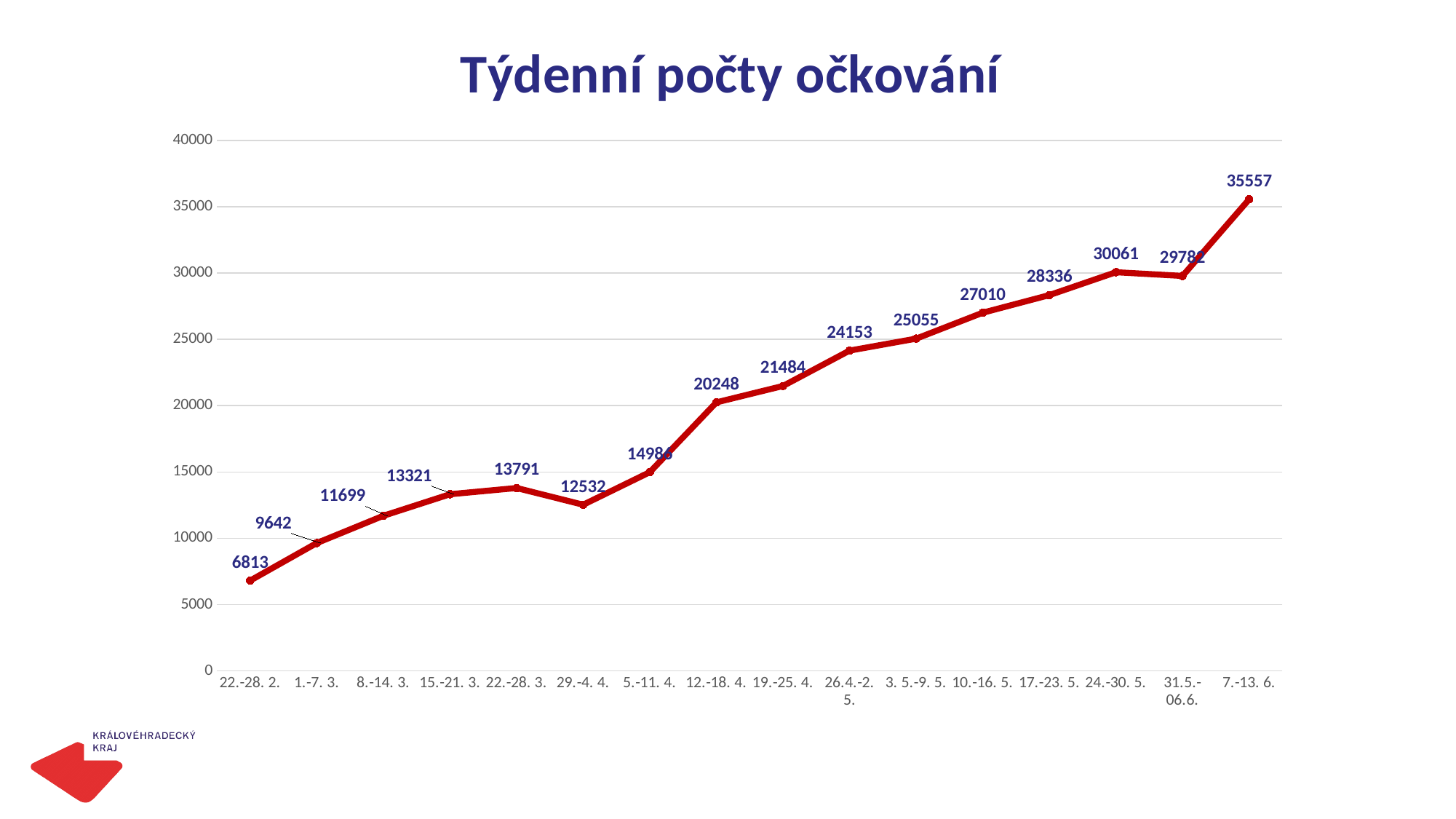
What type of chart is shown on the slide? line chart Which week has the lowest number of vaccinations? 22.-28. 2. What is the difference between the values for 7.-13. 6. and 24.-30. 5.? 5496 What is the value for the week 24.-30. 5.? 30061 What is the value for the week 22.-28. 2.? 6813 Which week has a higher value, 22.-28. 3. or 29.-4. 4.? 22.-28. 3. Is the value for the week 19.-25. 4. greater or less than 20000? greater What is the title of the chart? Týdenní počty očkování What is the value for the week 12.-18. 4.? 20248 How many weeks (data points) are plotted on the chart? 16 Which week has the highest number of vaccinations? 7.-13. 6. What is the difference between the values for 22.-28. 3. and 29.-4. 4.? 1259